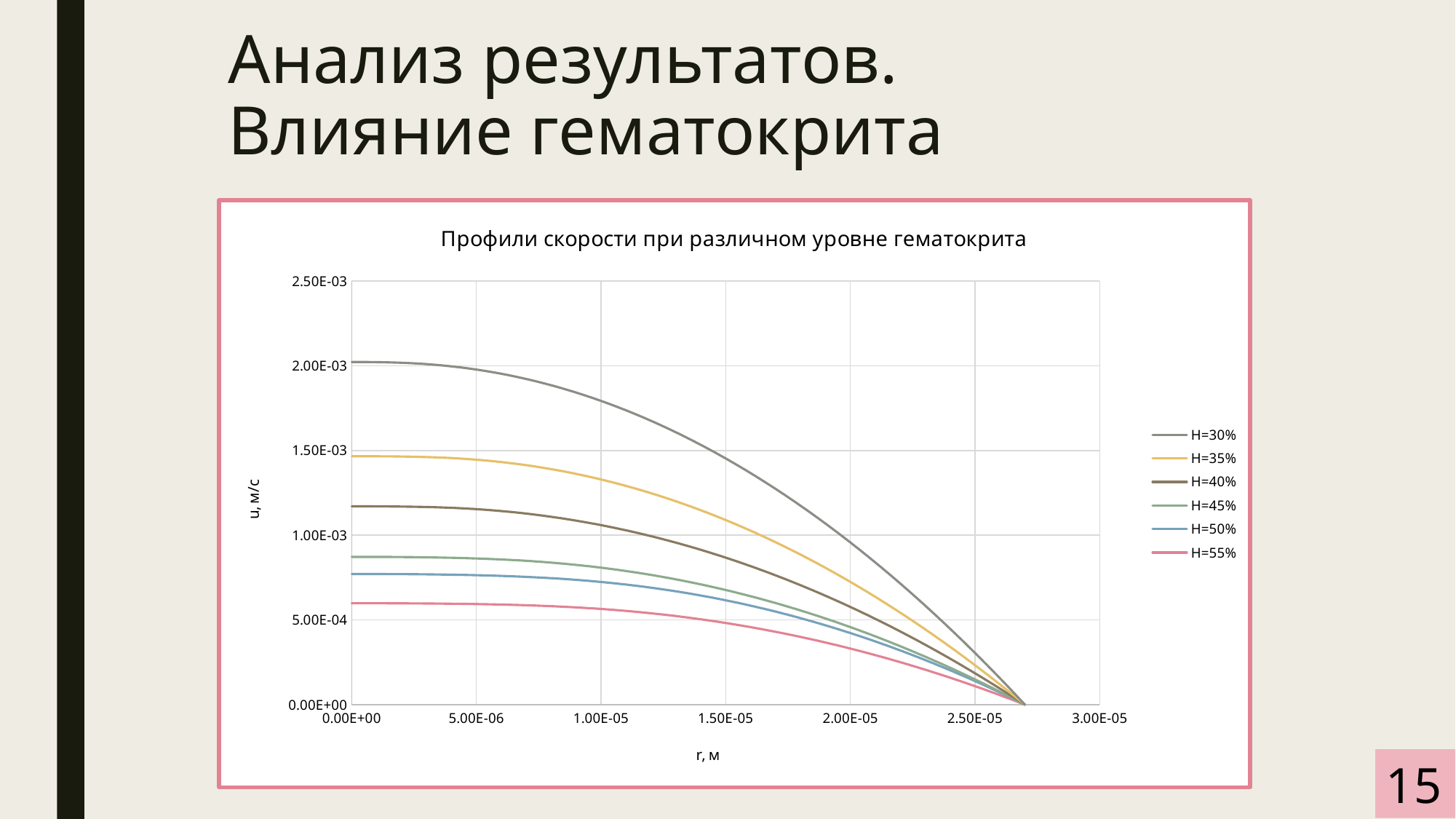
Which series has the highest velocity at r = 0.00E+00? H=30% What is the label of the vertical axis? u, м/с Is the value for H=40% at r = 0.00E+00 greater or less than 1.00E-03? greater Which series has the lowest velocity at r = 0.00E+00? H=55% What kind of chart is shown on the slide? line chart What is the title of the chart? Профили скорости при различном уровне гематокрита How many series does the legend list? 6 Is the value for H=55% at r = 0.00E+00 greater or less than 5.00E-04? greater Is the value for H=30% at r = 0.00E+00 greater or less than 1.50E-03? greater At r = 0.00E+00, which is larger: the value for H=35% or the value for H=50%? H=35% Do the velocity values rise or fall as r increases along the x axis? fall